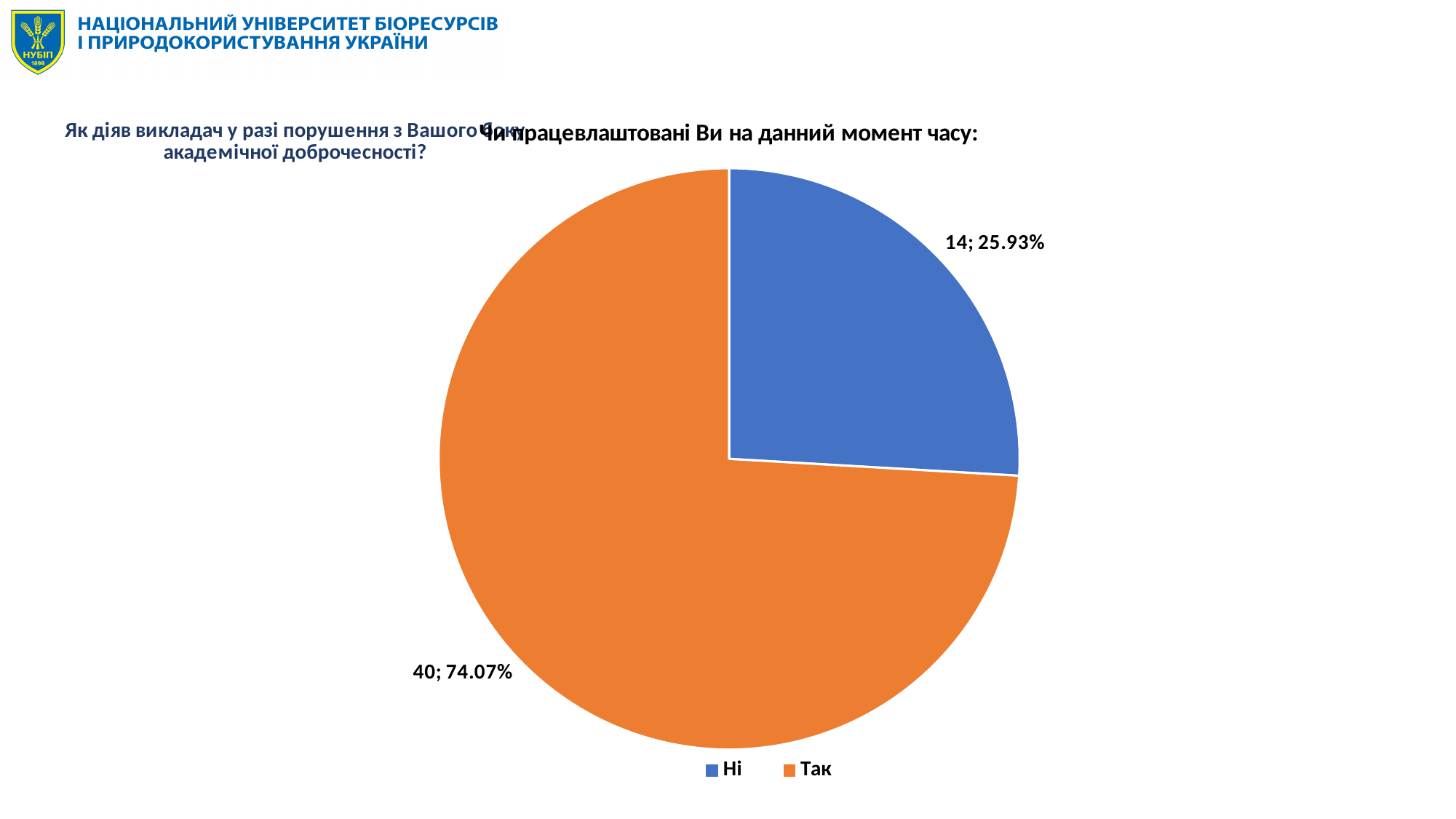
Which slice is the smallest in the pie chart? Ні What is the count shown for the "Ні" slice? 14 Which is larger, the "Ні" slice or the "Так" slice? Так What is the count shown for the "Так" slice? 40 How many slices does the pie chart have? 2 What kind of chart is shown on the slide? pie chart What share of the pie does the "Так" slice represent? 74.07% Which slice is the largest in the pie chart? Так What colour is the "Так" slice in the pie chart? orange How many entries does the legend of the pie chart list? 2 What is the difference between the counts for "Так" and "Ні"? 26 What share of the pie does the "Ні" slice represent? 25.93%